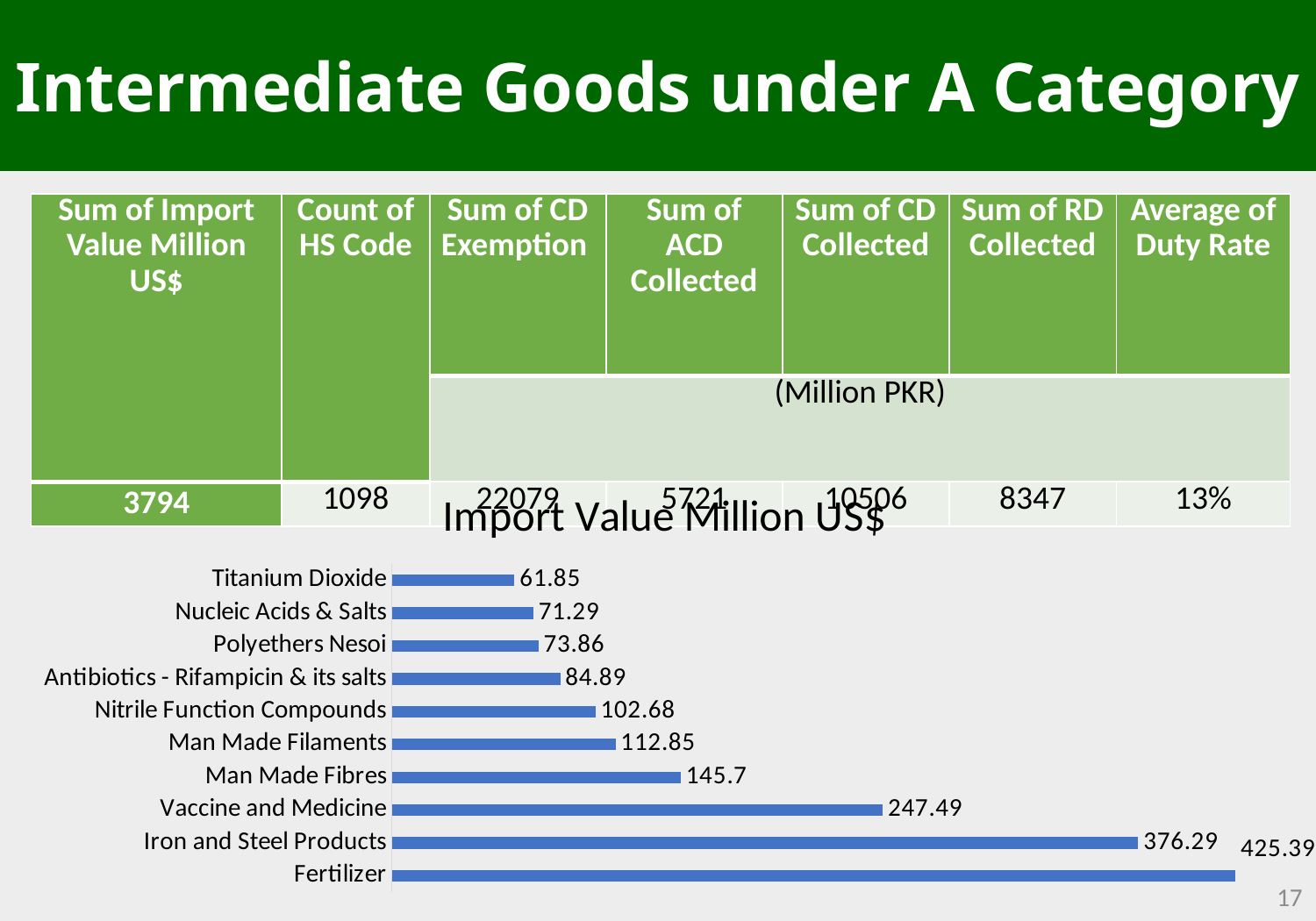
Which category has the lowest import value? Titanium Dioxide What kind of chart is shown on the slide? Bar chart How many categories are shown in the chart? 10 What is the import value for Man Made Fibres? 145.7 Which category has the highest import value? Fertilizer What is the import value for Nitrile Function Compounds? 102.68 What is the title of the chart? Import Value Million US$ What is the difference in import value between Fertilizer and Iron and Steel Products? 49.1 What is the import value for Vaccine and Medicine? 247.49 What is the import value for Fertilizer? 425.39 What is the difference in import value between Man Made Filaments and Man Made Fibres? 32.85 Which has a larger import value, Polyethers Nesoi or Antibiotics - Rifampicin & its salts? Antibiotics - Rifampicin & its salts